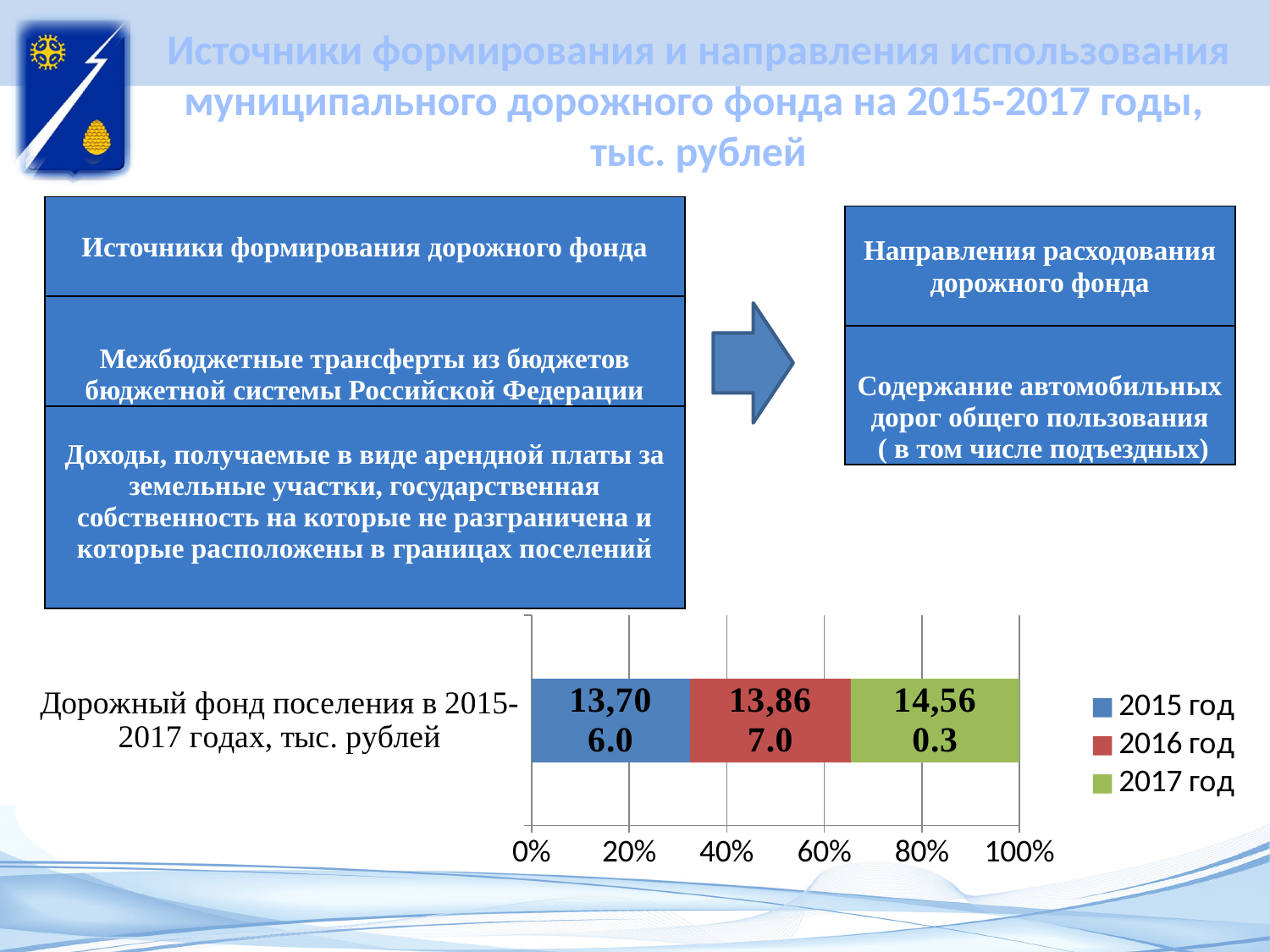
Which year has the highest value in the stacked bar chart? 2017 год What is the difference between the values for 2017 год and 2015 год? 854.3 What is the value for 2017 год in the stacked bar chart? 14,560.3 What colour represents 2016 год in the chart? Red What is the value for 2016 год in the stacked bar chart? 13,867.0 Do the values rise or fall from 2015 год to 2017 год? Rise What is the value for 2015 год in the stacked bar chart? 13,706.0 Which is larger, the value for 2016 год or the value for 2017 год? 2017 год What kind of chart is shown at the bottom of the slide? Stacked bar chart What is the difference between the values for 2016 год and 2015 год? 161.0 How many series does the legend of the chart list? 3 Which year has the lowest value in the stacked bar chart? 2015 год